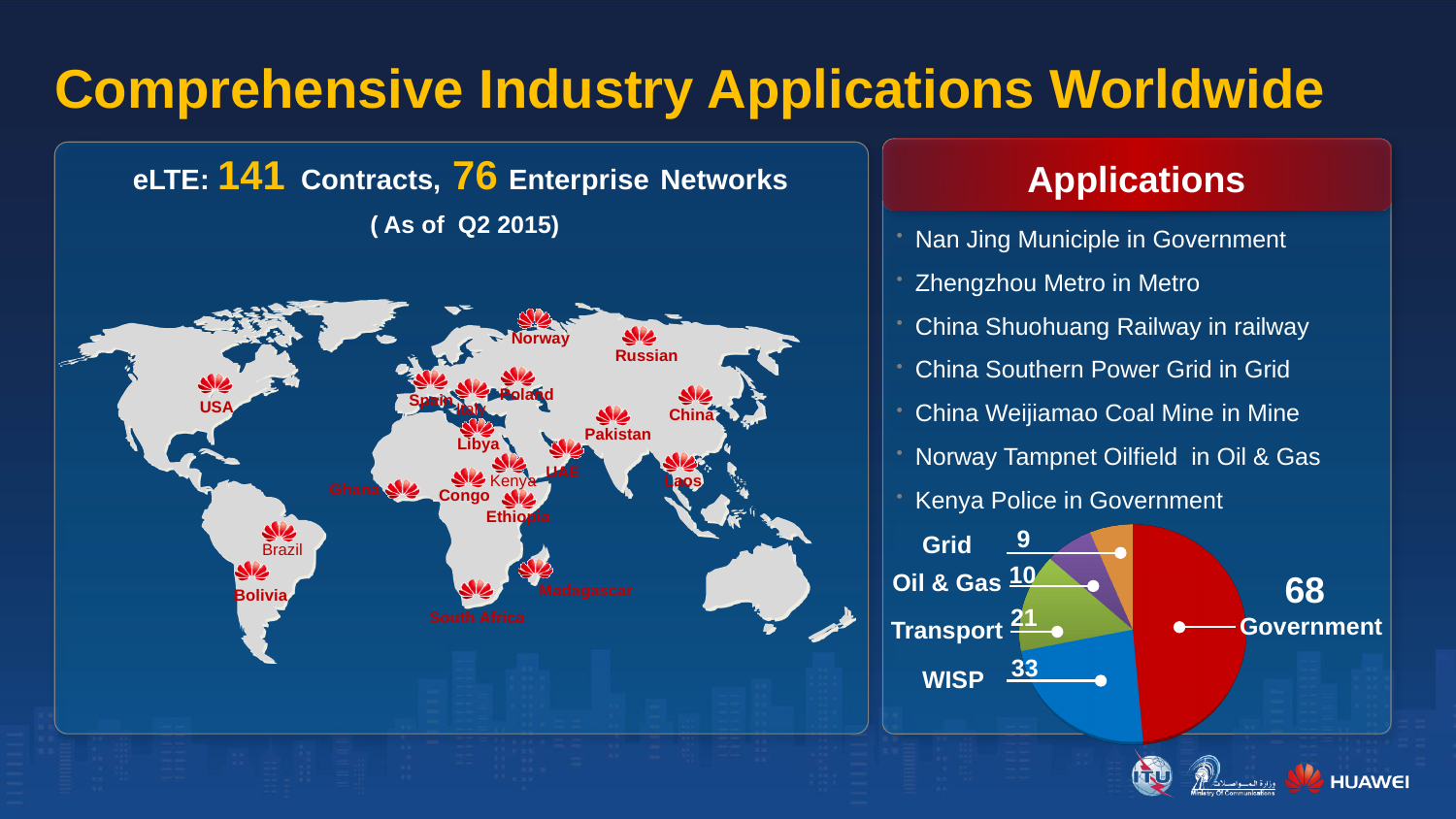
Which category has the largest slice in the pie chart? Government What type of chart is shown on the right side of the slide? pie chart In the pie chart, which is larger: Transport or Oil & Gas? Transport How many categories are shown in the pie chart? 5 What is the difference between the Government and WISP values in the pie chart? 35 What colour is the Government slice in the pie chart? red Which category has the smallest slice in the pie chart? Grid In the pie chart, what is the value for Government? 68 In the pie chart, what is the value for Transport? 21 In the pie chart, what is the value for WISP? 33 In the pie chart, what is the value for Oil & Gas? 10 In the pie chart, what is the value for Grid? 9